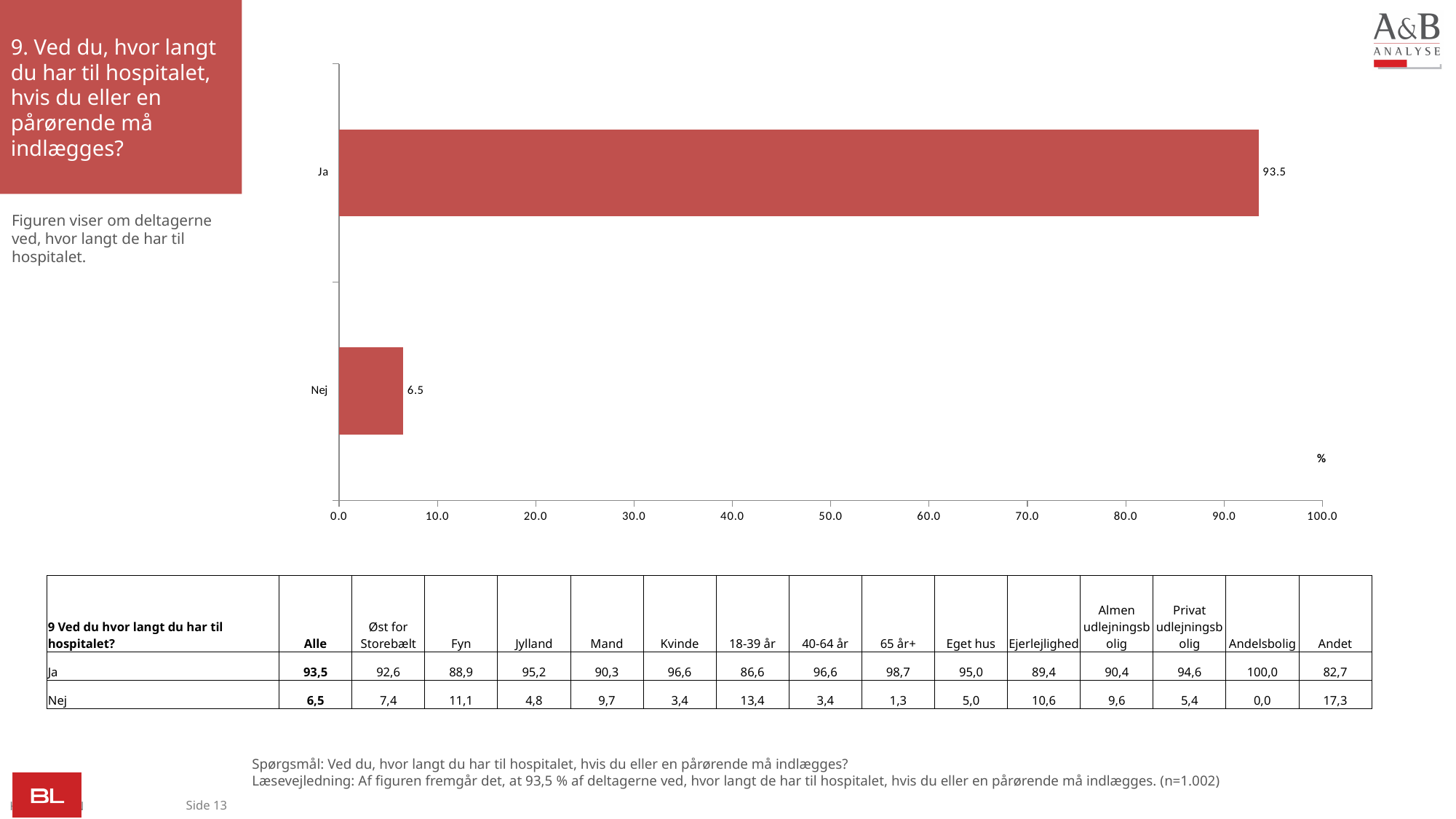
What is the difference between the values for Ja and Nej in the bar chart? 87.0 Is the value for Nej in the bar chart greater or less than 10.0? less Which category has the lowest value in the bar chart? Nej What is the value for Nej in the bar chart? 6.5 What is the maximum value shown on the x axis of the bar chart? 100.0 Is the value for Ja in the bar chart greater or less than 90.0? greater What is the value for Ja in the bar chart? 93.5 What kind of chart is shown on the slide? Bar chart Which is larger in the bar chart, the value for Ja or the value for Nej? Ja What is the total of the two bar values in the chart? 100.0 Which category has the highest value in the bar chart? Ja How many categories are shown in the bar chart? 2